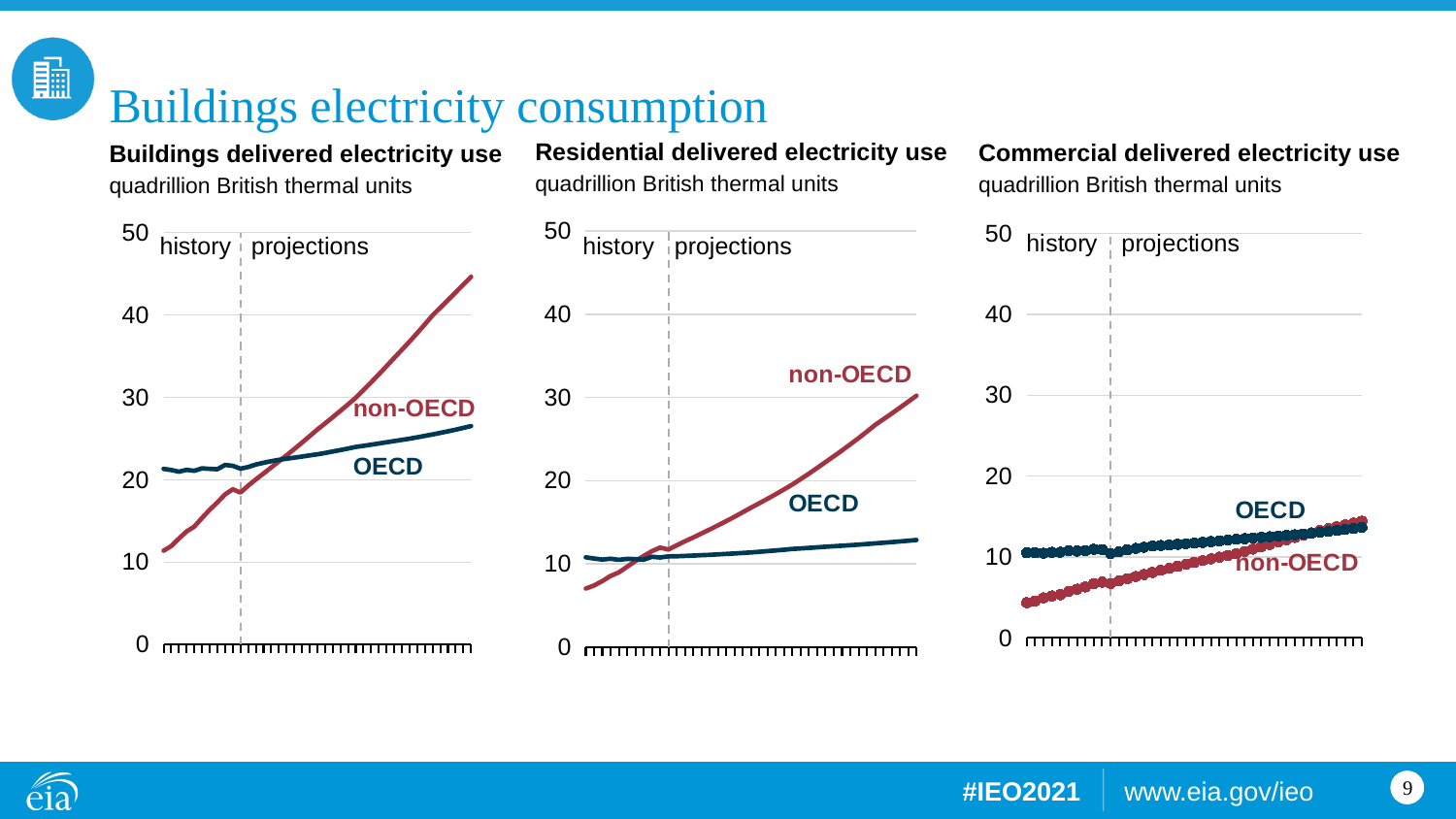
What kind of chart is 'Buildings delivered electricity use'? line chart In the 'Buildings delivered electricity use' chart, which series is higher at the end of the projections, OECD or non-OECD? non-OECD In the 'Buildings delivered electricity use' chart, does the non-OECD line rise or fall over the projection period? rise In the 'Buildings delivered electricity use' chart, is the non-OECD value at the end of the projections greater or less than 40? greater In the 'Residential delivered electricity use' chart, is the non-OECD value at the start of the history period greater or less than 10? less What unit is used on the y axis of the three charts? quadrillion British thermal units What two periods does the dashed vertical line separate in each chart? history and projections In the 'Commercial delivered electricity use' chart, does the non-OECD line rise or fall along the x axis? rise In the 'Residential delivered electricity use' chart, how many series are plotted? 2 In the 'Residential delivered electricity use' chart, is the OECD value at the end of the projections greater or less than 20? less In the 'Commercial delivered electricity use' chart, which series is higher at the start of the history period, OECD or non-OECD? OECD